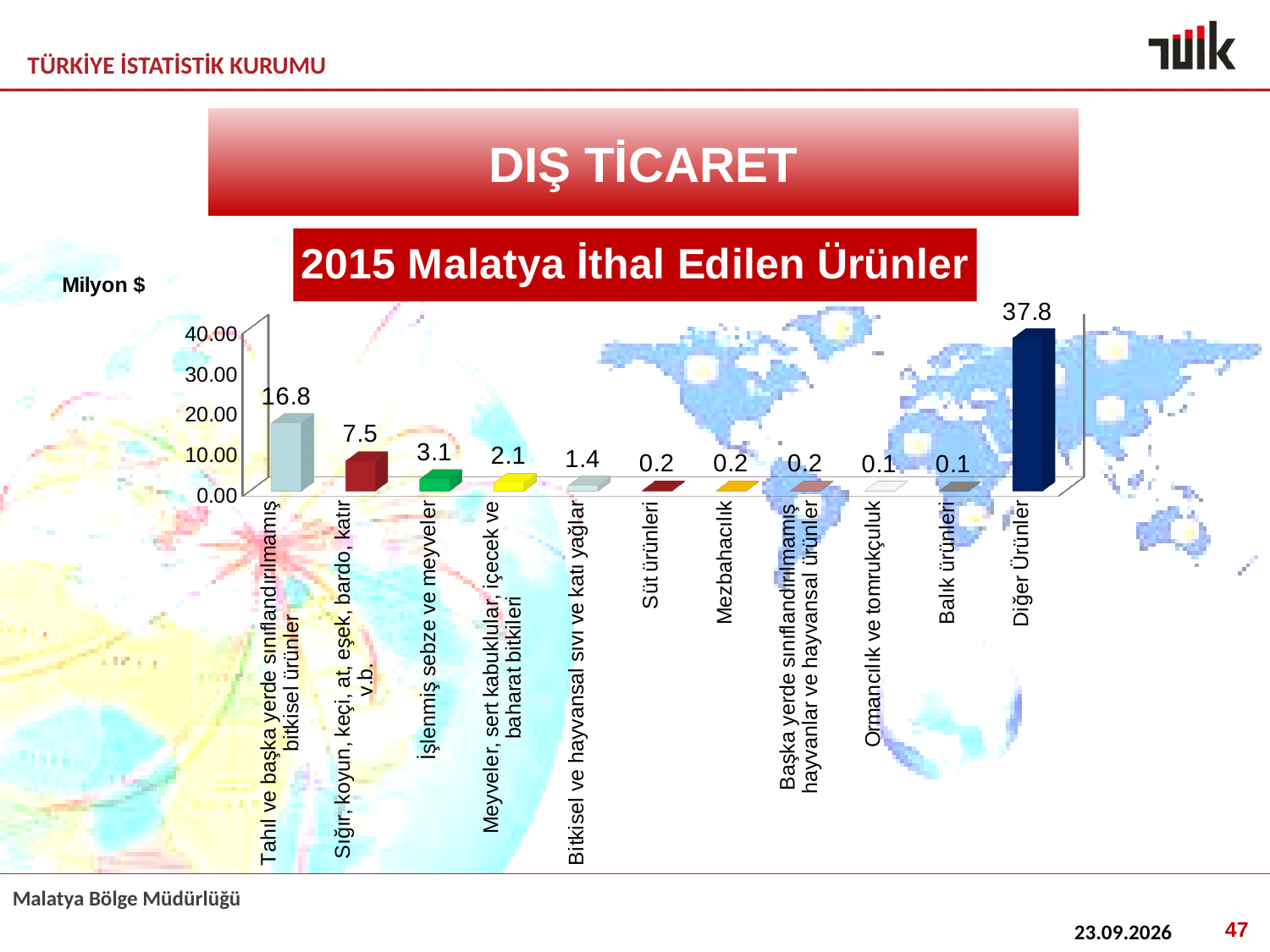
Which category has the highest value? Diğer Ürünler What kind of chart is shown on the slide? bar chart What is the difference between the values for Diğer Ürünler and Tahıl ve başka yerde sınıflandırılmamış bitkisel ürünler? 21.0 What is the value for Diğer Ürünler? 37.8 Is the value for Tahıl ve başka yerde sınıflandırılmamış bitkisel ürünler greater or less than 10.00? greater What is the value for Balık ürünleri? 0.1 What unit is indicated for the values in the chart? Milyon $ Which is larger, the value for Meyveler, sert kabuklular, içecek ve baharat bitkileri or the value for Bitkisel ve hayvansal sıvı ve katı yağlar? Meyveler, sert kabuklular, içecek ve baharat bitkileri What is the value for İşlenmiş sebze ve meyveler? 3.1 What is the difference between the values for Sığır, koyun, keçi, at, eşek, bardo, katır v.b. and İşlenmiş sebze ve meyveler? 4.4 What is the value for Süt ürünleri? 0.2 How many categories are shown in the chart? 11